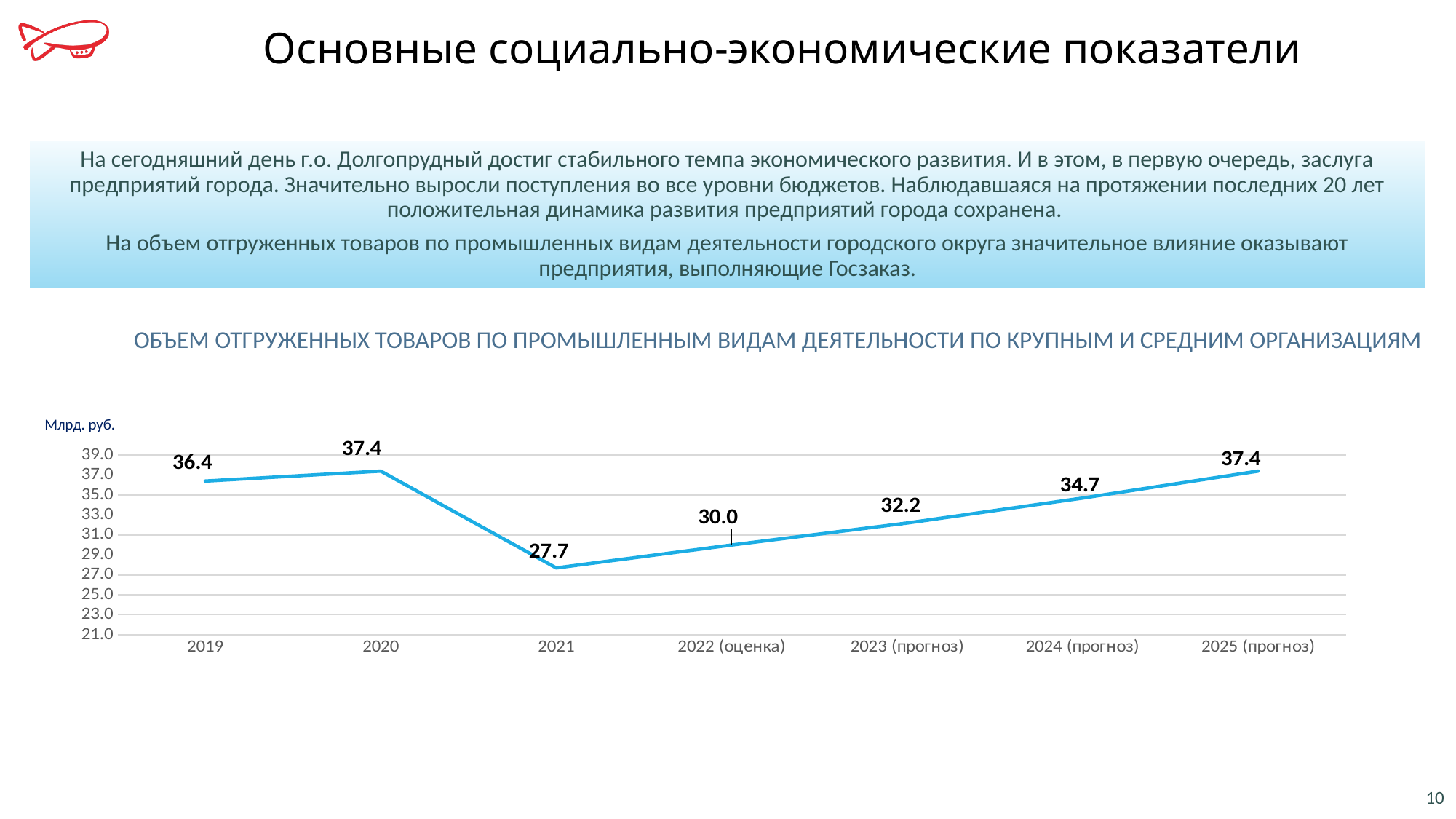
Which year has the lowest value? 2021 What is the value for 2019? 36.4 Which is larger, the value for 2019 or the value for 2023 (прогноз)? 2019 What is the value for 2024 (прогноз)? 34.7 What is the difference between the values for 2025 (прогноз) and 2022 (оценка)? 7.4 What is the difference between the values for 2020 and 2021? 9.7 What unit is shown on the chart's vertical axis label? Млрд. руб. What is the value for 2022 (оценка)? 30.0 How many data points are plotted on the chart? 7 What kind of chart is shown on the slide? line chart What is the value for 2021? 27.7 Do the values rise or fall from 2021 to 2025 (прогноз)? rise